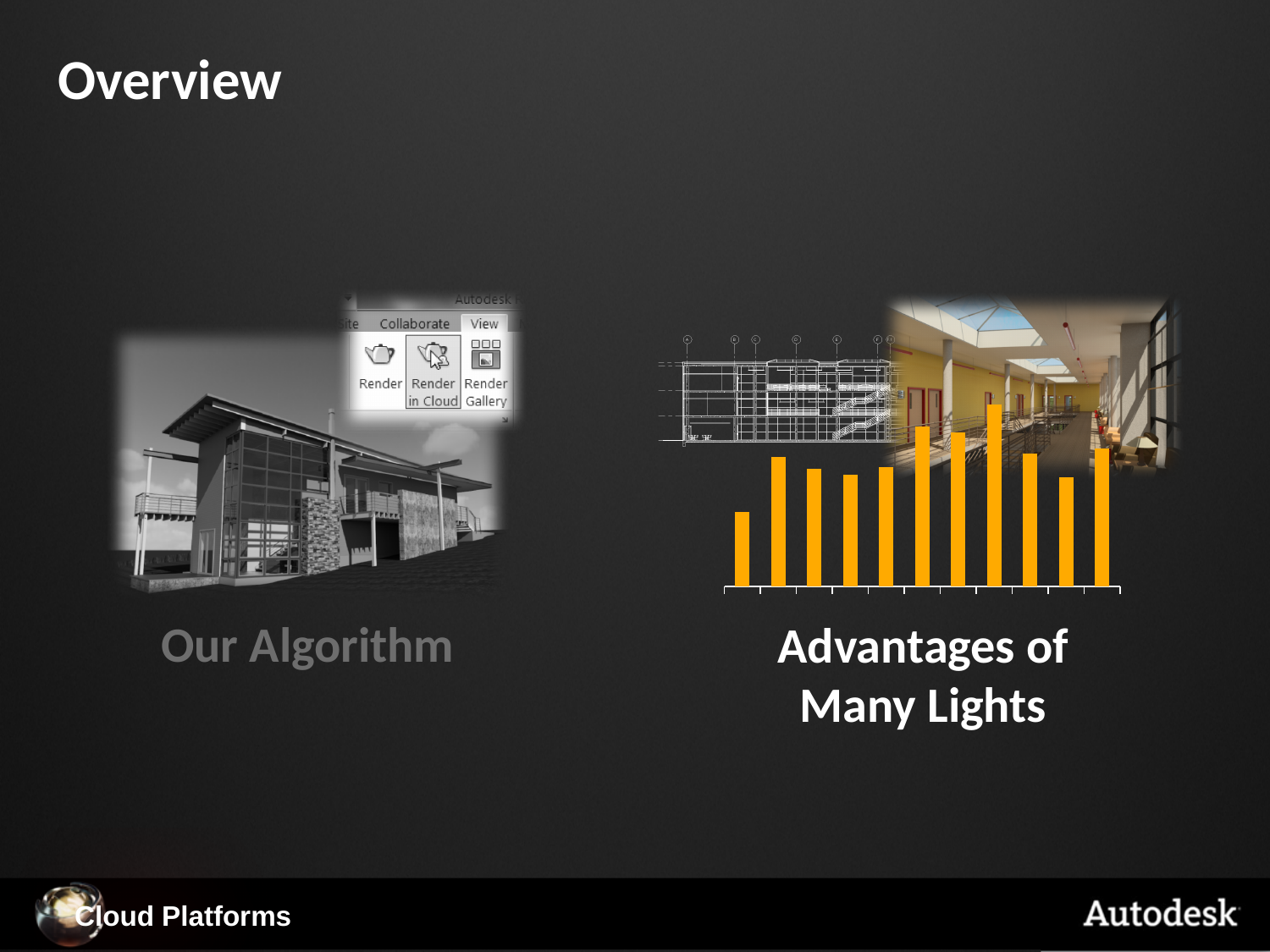
What caption appears directly below the bar chart on the right side of the slide? Advantages of Many Lights Does the bar chart on the right side of the slide show any numeric axis labels or data labels? No In the bar chart on the right side of the slide, which bar, counted from the left, is the shortest? the 1st bar How many bars does the bar chart on the right side of the slide contain? 11 In the bar chart on the right side of the slide, which is taller: the 10th bar or the 11th bar from the left? the 11th bar In the bar chart on the right side of the slide, which is taller: the 9th bar or the 10th bar from the left? the 9th bar In the bar chart on the right side of the slide, which bar, counted from the left, is the tallest? the 8th bar What colour are the bars in the bar chart on the right side of the slide? orange What kind of chart is shown on the right side of the slide, above the caption "Advantages of Many Lights"? bar chart In the bar chart on the right side of the slide, which is taller: the first bar or the second bar from the left? the second bar